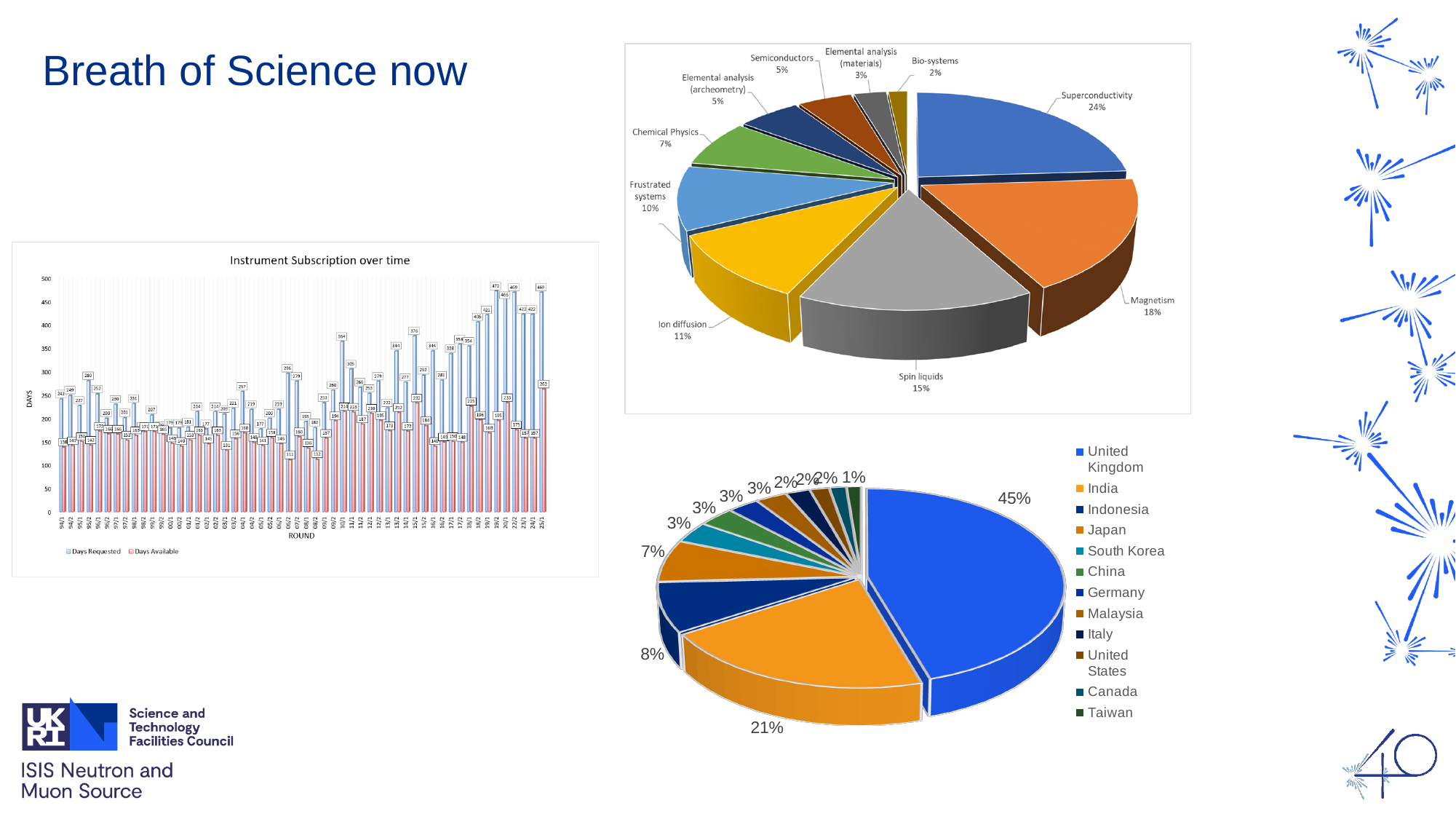
How many slices does the top-right pie chart have? 10 In the top-right pie chart, which category has the smallest share? Bio-systems In the bottom-right pie chart, what share does the United Kingdom have? 45% In the bottom-right pie chart, what share does India have? 21% In the top-right pie chart, what is the difference in percentage points between Magnetism and Ion diffusion? 7 How many series does the legend of the 'Instrument Subscription over time' chart list? 2 How many countries does the legend of the bottom-right pie chart list? 12 In the top-right pie chart, which category has the largest share? Superconductivity In the top-right pie chart, what share does Spin liquids have? 15% In the bottom-right pie chart, which is larger, the share for Indonesia or the share for Japan? Indonesia What type of chart is the 'Instrument Subscription over time' chart on the left? bar chart In the top-right pie chart, what share does Superconductivity have? 24%